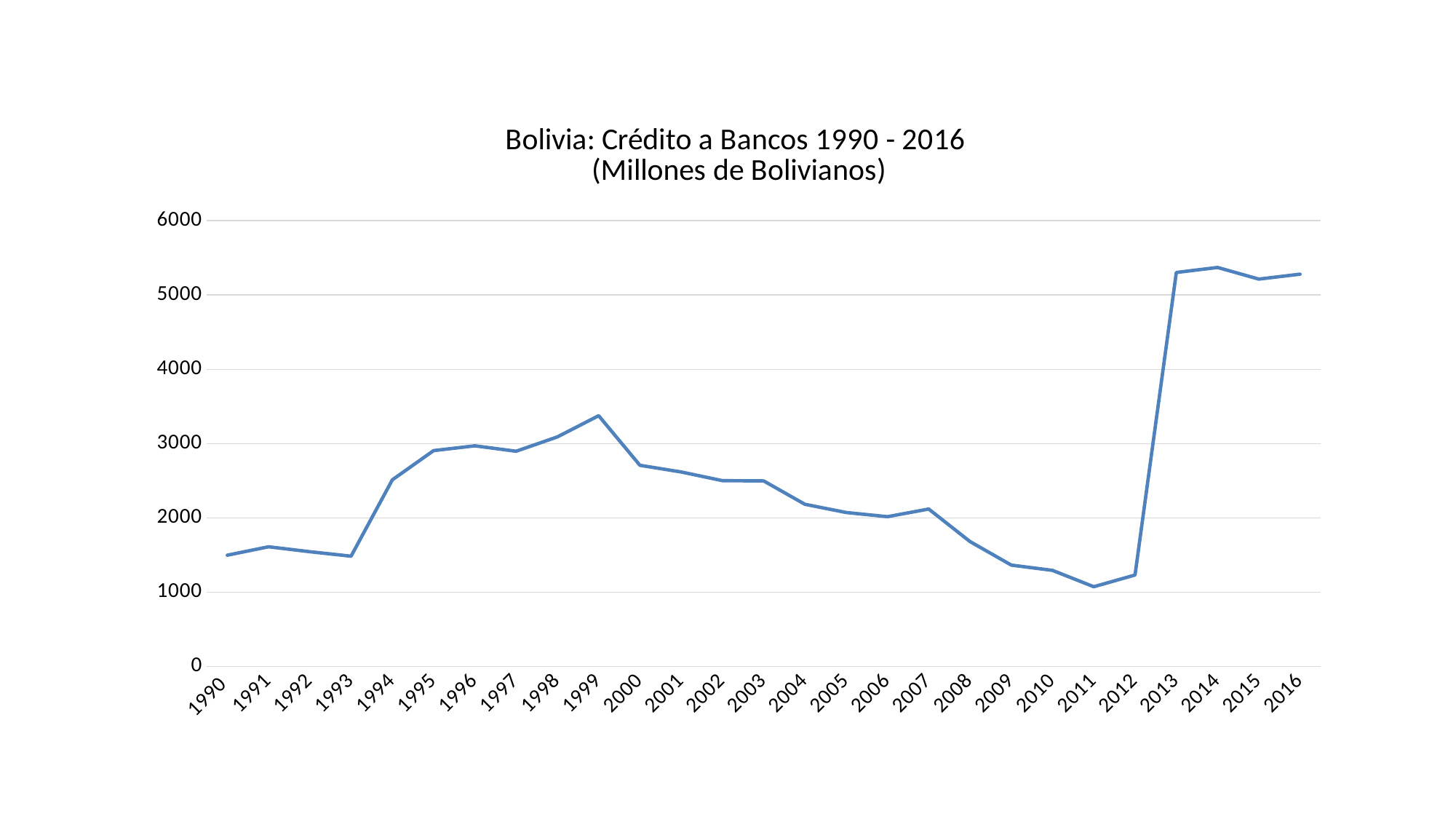
Is the value for 2009 greater or less than 2000? less Do the values rise or fall from 2007 to 2011? fall Is the value for 2013 greater or less than 5000? greater Which year has the larger value, 1999 or 2007? 1999 What is the title of the chart? Bolivia: Crédito a Bancos 1990 - 2016 (Millones de Bolivianos) Which year has the larger value, 2012 or 2013? 2013 Which year has the lowest value? 2011 Which year has the highest value? 2014 How many years are plotted along the x axis? 27 What kind of chart is shown on the slide? line chart Is the value for 1999 greater or less than 3000? greater